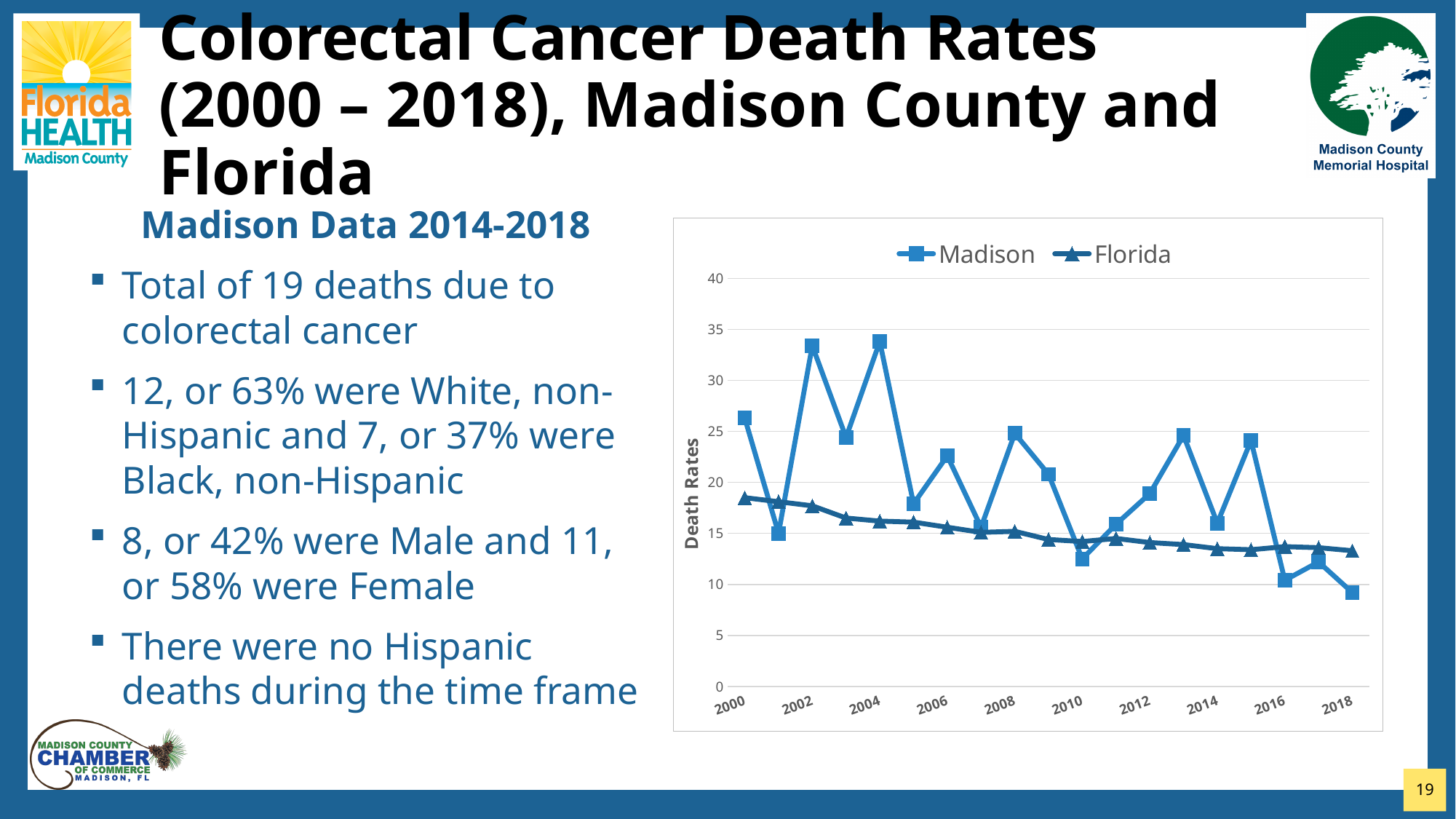
Is the Madison value for 2018 greater or less than 10? less What kind of chart is shown on the slide? line chart Is the Florida value for 2000 greater or less than 20? less What are the two series named in the chart's legend? Madison and Florida What is the label on the chart's vertical axis? Death Rates In 2004, which series has the higher death rate, Madison or Florida? Madison Is the Madison value for 2000 greater or less than 25? greater How many years of data points does each series in the chart cover? 19 How many series does the chart's legend list? 2 In 2018, which series has the higher death rate, Madison or Florida? Florida Does the Florida series generally rise or fall from 2000 to 2018? fall